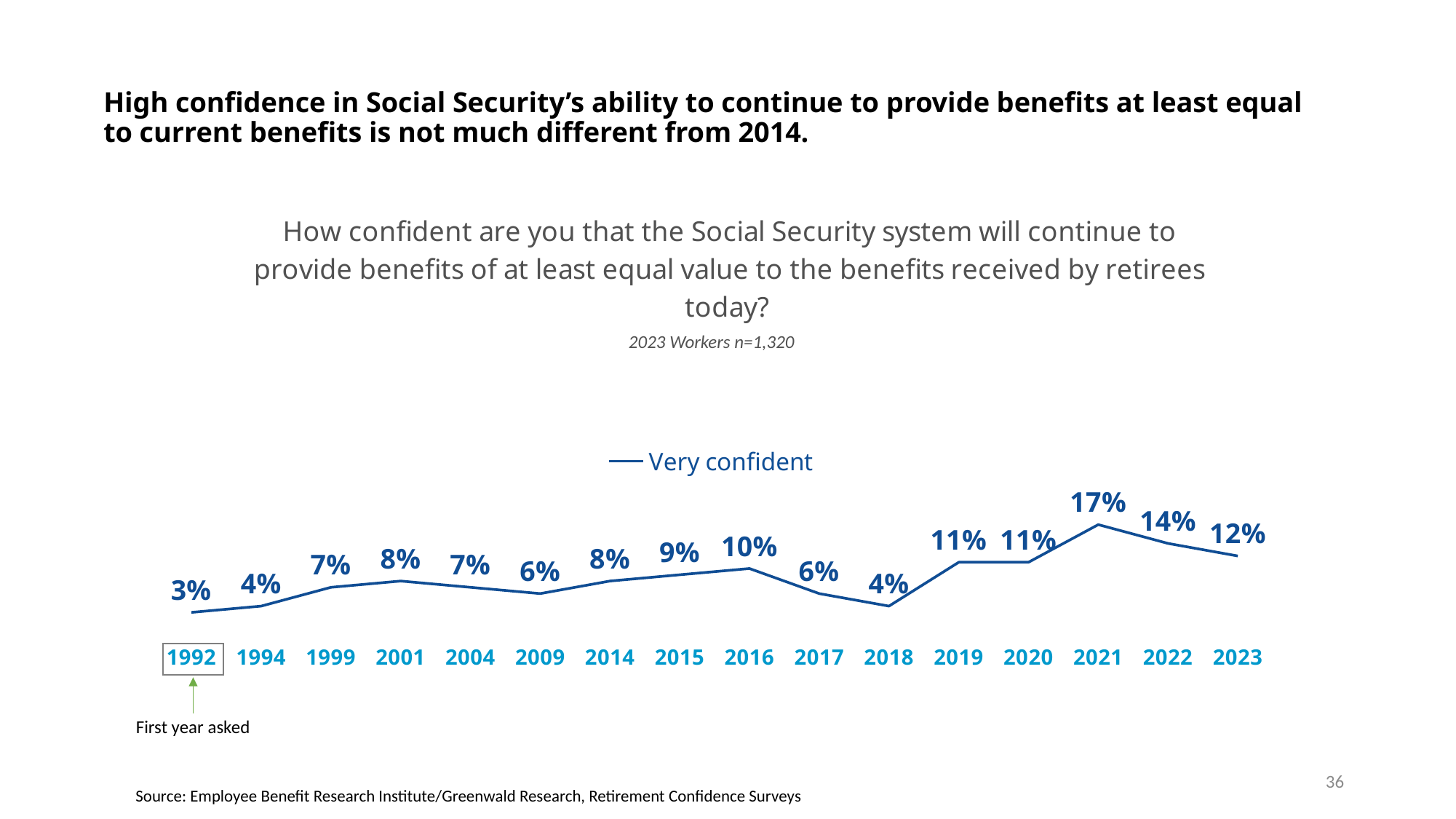
How many percentage points higher was the 'Very confident' share in 2021 than in 2018? 13 Which year had a higher 'Very confident' share, 2016 or 2017? 2016 In which year was the 'Very confident' share highest? 2021 What is the name of the series shown in the chart legend? Very confident What was the 'Very confident' value in 2018? 4% How many years are shown on the x axis of the chart? 16 What is the difference in percentage points between the 2023 value and the 2014 value? 4 What was the 'Very confident' value in 1992? 3% What type of chart is shown on the slide? Line chart What percentage of workers were very confident in 2023? 12% What percentage of workers were very confident in 2021? 17% In which year was the 'Very confident' share lowest? 1992